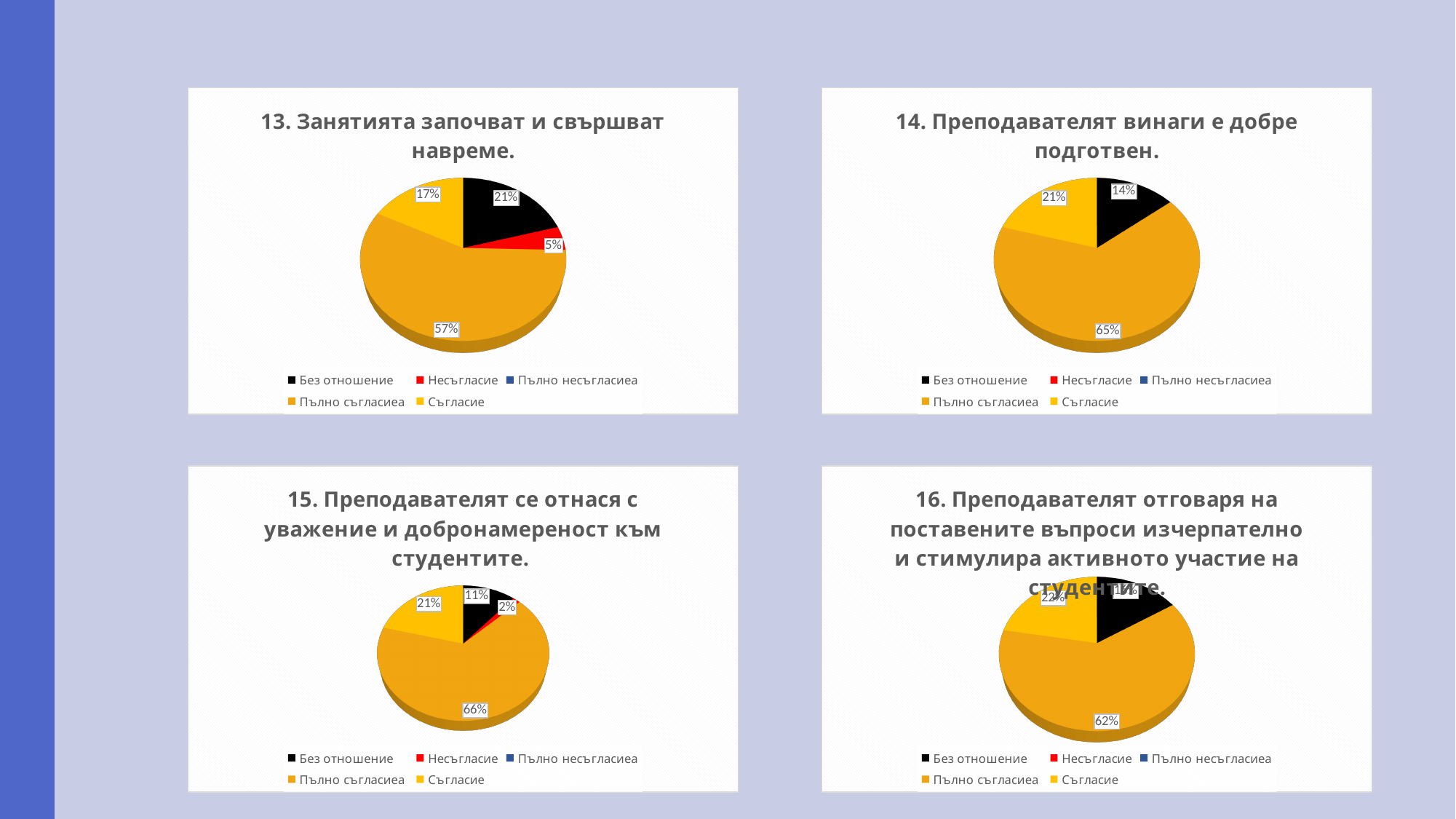
In the chart titled "13. Занятията започват и свършват навреме.", what share is labelled for Пълно съгласиеа? 57% How many entries does the legend list in the chart titled "15. Преподавателят се отнася с уважение и добронамереност към студентите."? 5 In the chart titled "16. Преподавателят отговаря на поставените въпроси изчерпателно и стимулира активното участие на студентите.", what share is labelled for Пълно съгласиеа? 62% In the chart titled "15. Преподавателят се отнася с уважение и добронамереност към студентите.", what share is labelled for Без отношение? 11% In the chart titled "13. Занятията започват и свършват навреме.", which category has the largest slice? Пълно съгласиеа In the chart titled "15. Преподавателят се отнася с уважение и добронамереност към студентите.", which category has the smallest visible slice? Несъгласие In the chart titled "16. Преподавателят отговаря на поставените въпроси изчерпателно и стимулира активното участие на студентите.", what share is labelled for Съгласие? 22% In the chart titled "13. Занятията започват и свършват навреме.", what share is labelled for Несъгласие? 5% In the chart titled "14. Преподавателят винаги е добре подготвен.", what is the difference between the Пълно съгласиеа share and the Без отношение share? 51% Which is larger in the chart titled "13. Занятията започват и свършват навреме.": the Без отношение share or the Съгласие share? Без отношение In the chart titled "14. Преподавателят винаги е добре подготвен.", what share is labelled for Съгласие? 21% What type of chart is used for "14. Преподавателят винаги е добре подготвен."? Pie chart